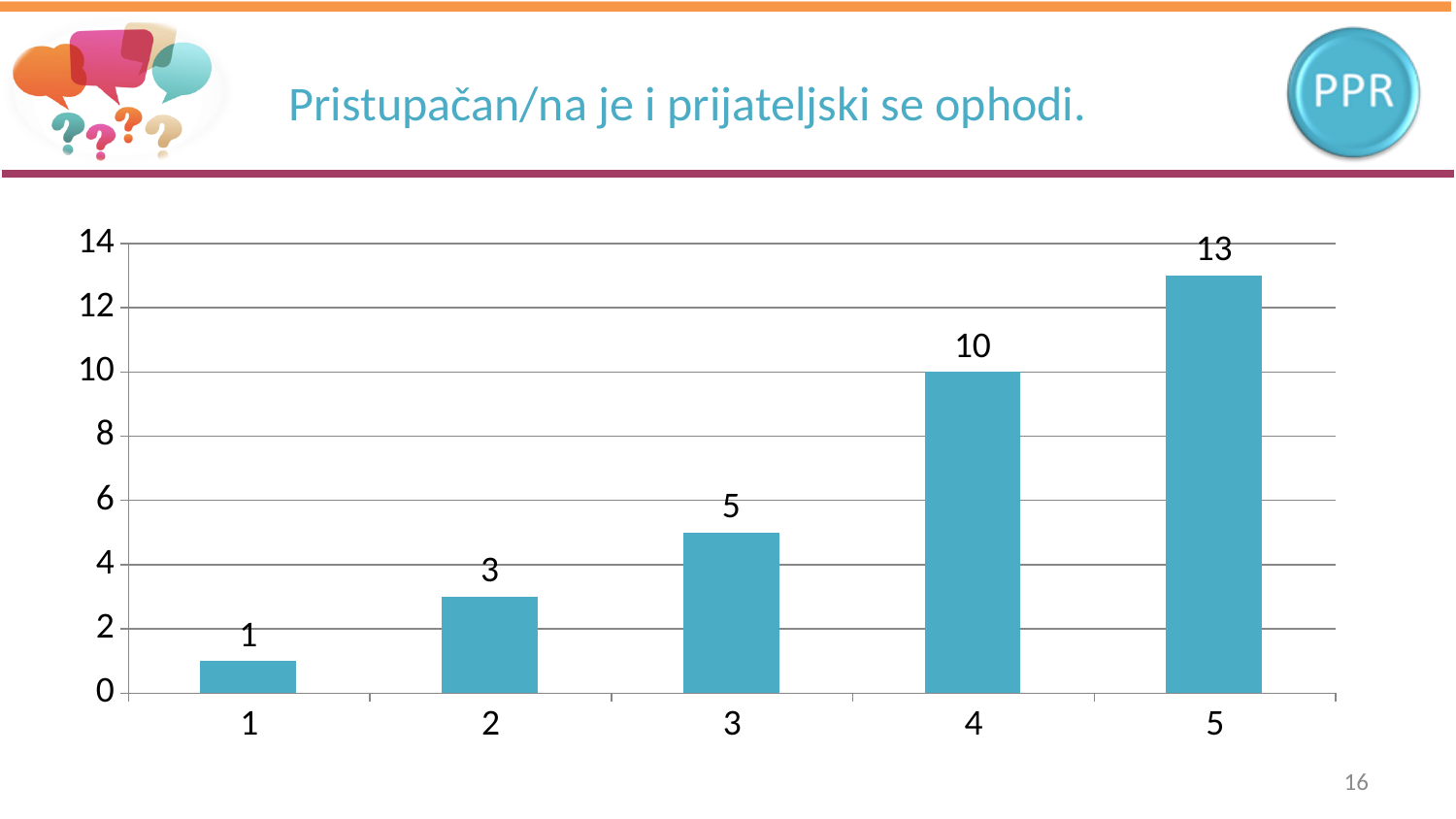
Which category has the lowest value? 1 What is the value for category 3? 5 Which is larger, the value for category 2 or the value for category 3? 3 Is the value for category 5 greater or less than 12? greater How many categories are shown on the x axis? 5 What is the value for category 1? 1 What is the difference between the values for category 3 and category 2? 2 What is the difference between the values for category 5 and category 4? 3 Which category has the highest value? 5 What kind of chart is shown on the slide? bar chart Do the values rise or fall from category 1 to category 5? rise What is the value for category 4? 10